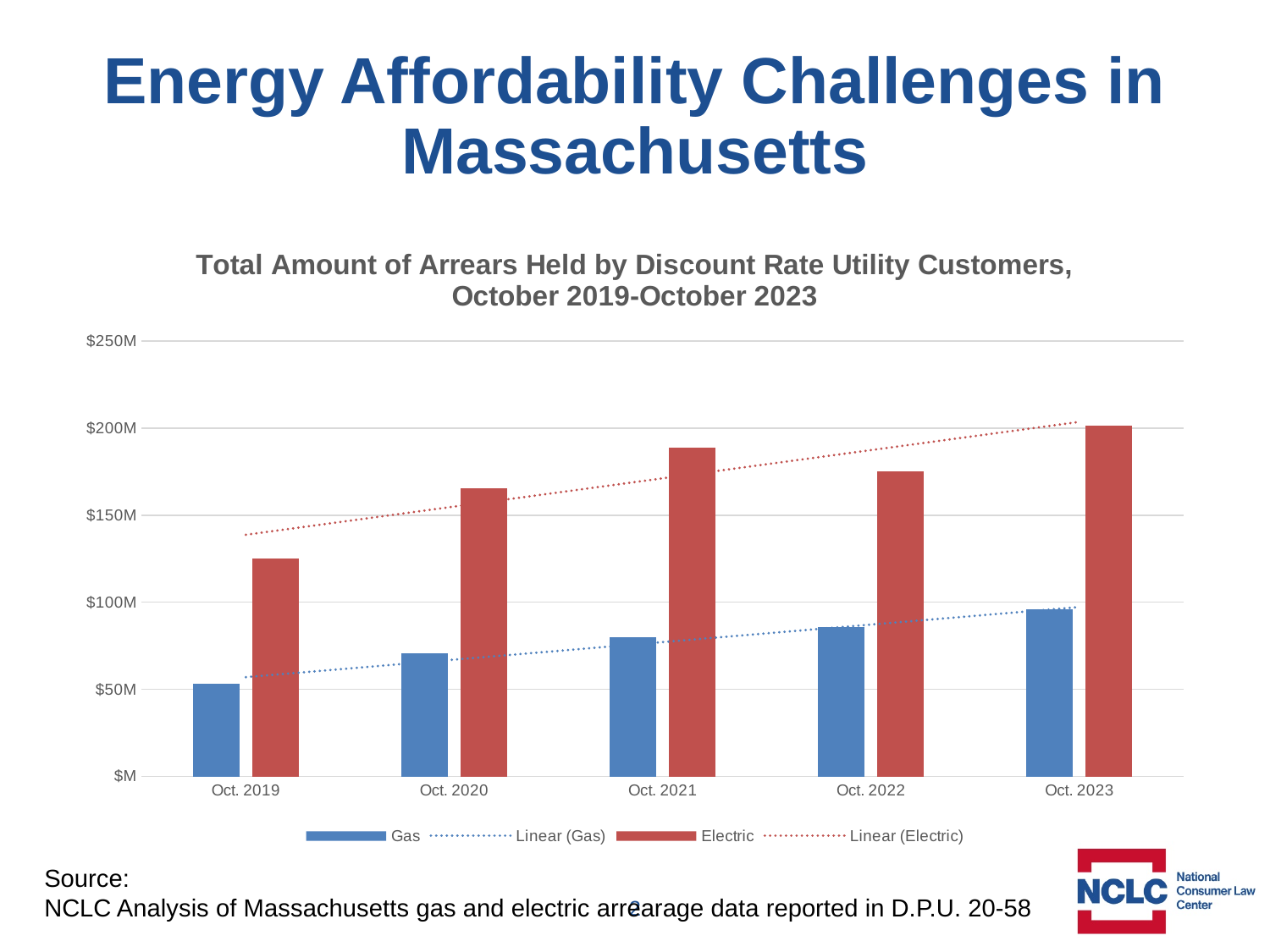
How many entries does the chart's legend list? 4 In which period is the Electric arrears value highest? Oct. 2023 How many time periods are shown on the x axis of the chart? 5 Which is larger, the Electric value for Oct. 2021 or the Electric value for Oct. 2022? Oct. 2021 Do the Gas arrears values rise or fall from Oct. 2019 to Oct. 2023? Rise In which period is the Gas arrears value highest? Oct. 2023 Is the Electric value for Oct. 2020 greater or less than $150M? greater Is the Electric value for Oct. 2019 greater or less than $100M? greater In which period is the Gas arrears value lowest? Oct. 2019 What kind of chart is shown on the slide? Bar chart Is the Gas value for Oct. 2019 greater or less than $100M? less What colour are the Electric bars in the chart? Red